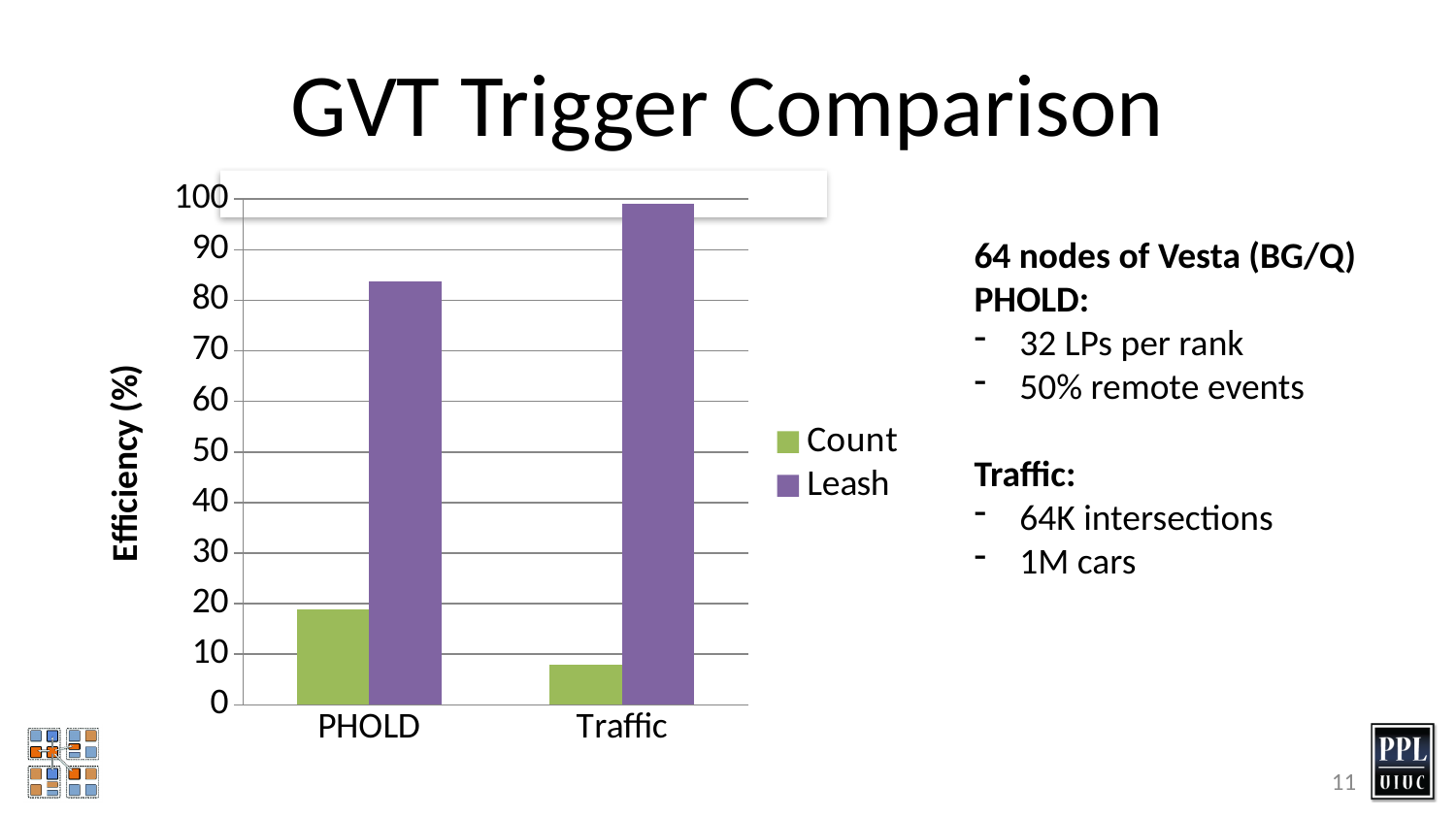
Is the Count value for PHOLD greater or less than 30? less How many categories are shown on the x axis of the chart? 2 What kind of chart is shown on the slide? bar chart Which category has the larger Count value, PHOLD or Traffic? PHOLD Is the Leash value for PHOLD greater or less than 70? greater What is the label of the chart's y axis? Efficiency (%) What are the two series named in the chart's legend? Count and Leash Which category has the larger Leash value, PHOLD or Traffic? Traffic Which category and series has the highest bar in the chart? Leash for Traffic How many series does the chart's legend list? 2 Which category and series has the lowest bar in the chart? Count for Traffic Is the Leash value for Traffic greater or less than 90? greater